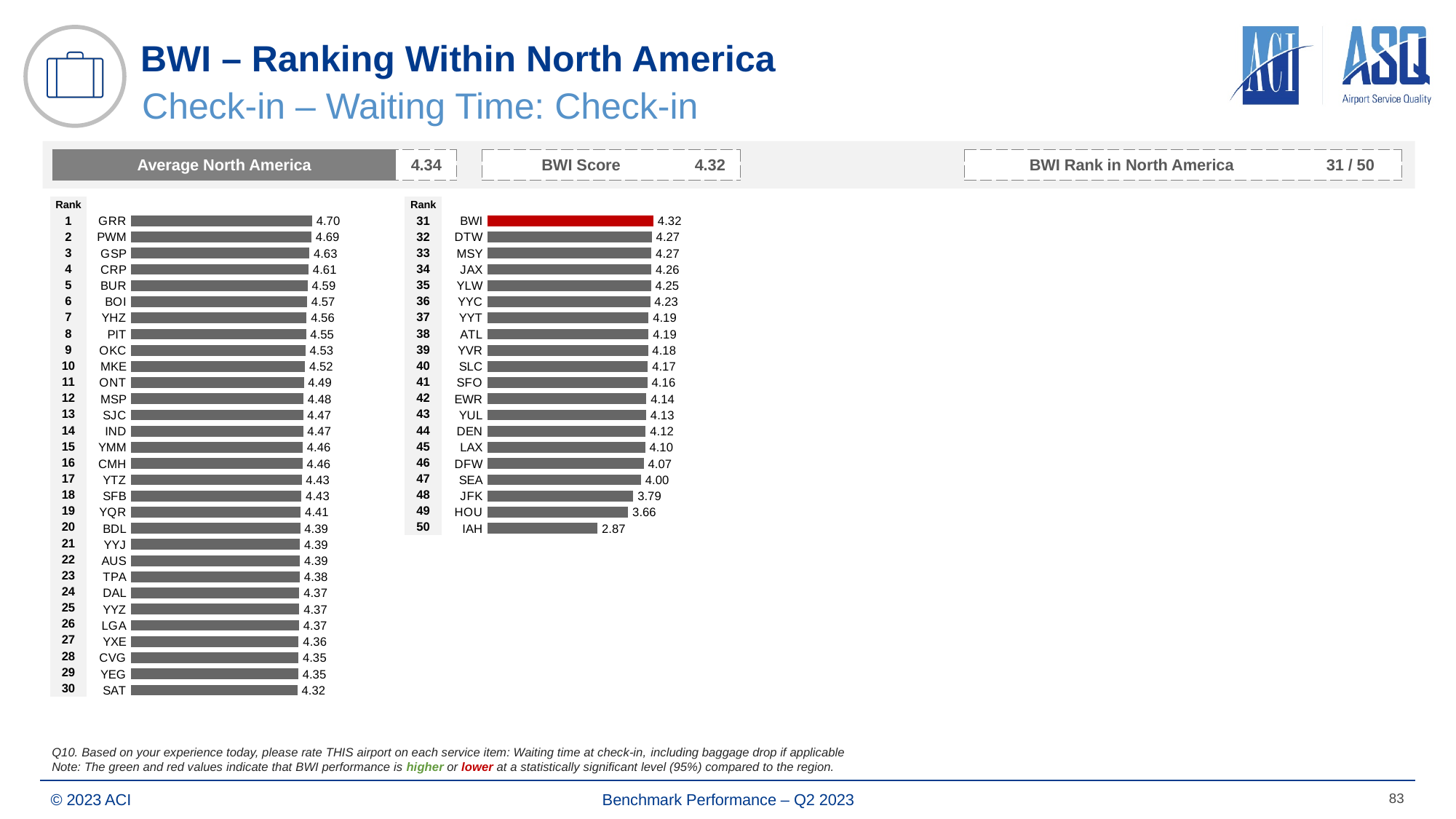
How many airports are plotted on the right chart (ranks 31-50)? 20 On the right chart (ranks 31-50), which is larger, the value for JFK or the value for HOU? JFK How many airports are plotted on the left chart (ranks 1-30)? 30 On the right chart (ranks 31-50), what is the value for BWI? 4.32 On the left chart (ranks 1-30), which airport has the highest value? GRR On the right chart (ranks 31-50), which bar is highlighted in red? BWI On the right chart (ranks 31-50), which airport has the lowest value? IAH On the left chart (ranks 1-30), what is the difference between the values for GRR and SAT? 0.38 What kind of chart is used to show the airport rankings on this slide? Bar chart On the right chart (ranks 31-50), what is the value for IAH? 2.87 On the left chart (ranks 1-30), what is the value for GRR? 4.70 On the right chart (ranks 31-50), what is the difference between the values for BWI and IAH? 1.45